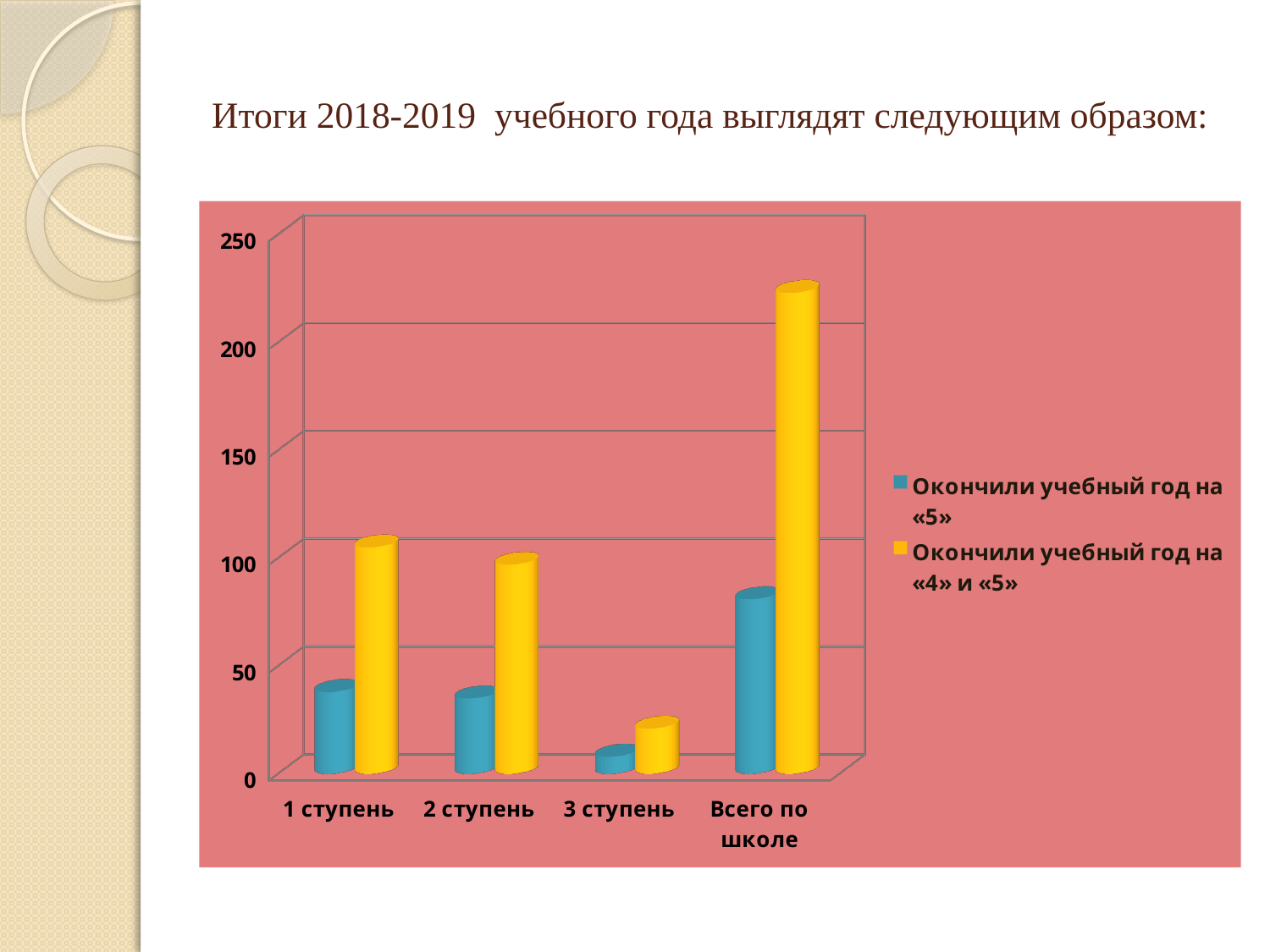
Is the value for «3 ступень» in the series «Окончили учебный год на «4» и «5»» greater or less than 50? less Which category has the highest value for the series «Окончили учебный год на «4» и «5»»? Всего по школе How many categories are shown on the x axis of the chart? 4 How many series does the chart's legend list? 2 What kind of chart is shown on the slide? bar chart Is the value for «Всего по школе» in the series «Окончили учебный год на «5»» greater or less than 100? less For «1 ступень», which series has the larger value: «Окончили учебный год на «5»» or «Окончили учебный год на «4» и «5»»? Окончили учебный год на «4» и «5» Which category has the lowest value for the series «Окончили учебный год на «4» и «5»»? 3 ступень Which colour represents the series «Окончили учебный год на «5»» in the chart? blue Is the value for «Всего по школе» in the series «Окончили учебный год на «4» и «5»» greater or less than 200? greater Which category has the lowest value for the series «Окончили учебный год на «5»»? 3 ступень